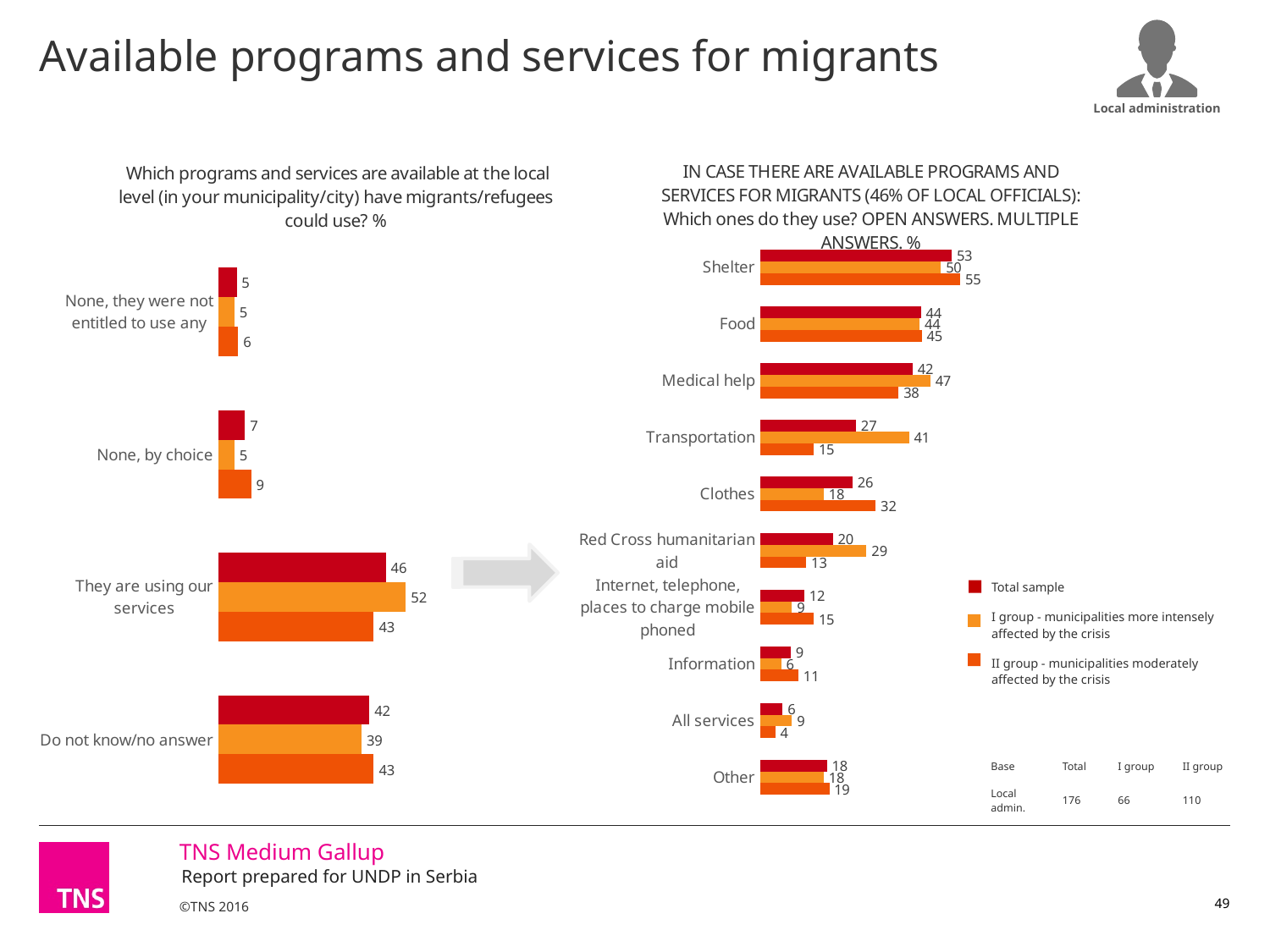
How many series does the legend list? 3 In the right chart, which category has the lowest II group value? All services What type of chart is the right chart? Bar chart In the right chart, which is larger for Transportation: the I group value or the II group value? I group In the left chart, what is the I group value for "Do not know/no answer"? 39 In the left chart, what is the difference between the I group and II group values for "They are using our services"? 9 In the right chart, what is the difference between the Total sample values for Shelter and Food? 9 In the left chart, which category has the highest I group value? They are using our services In the right chart ("In case there are available programs and services for migrants..."), what is the II group value for Shelter? 55 In the left chart, how many categories are shown? 4 In the left chart ("Which programs and services are available at the local level..."), what is the Total sample value for "They are using our services"? 46 In the right chart, what is the I group value for Medical help? 47